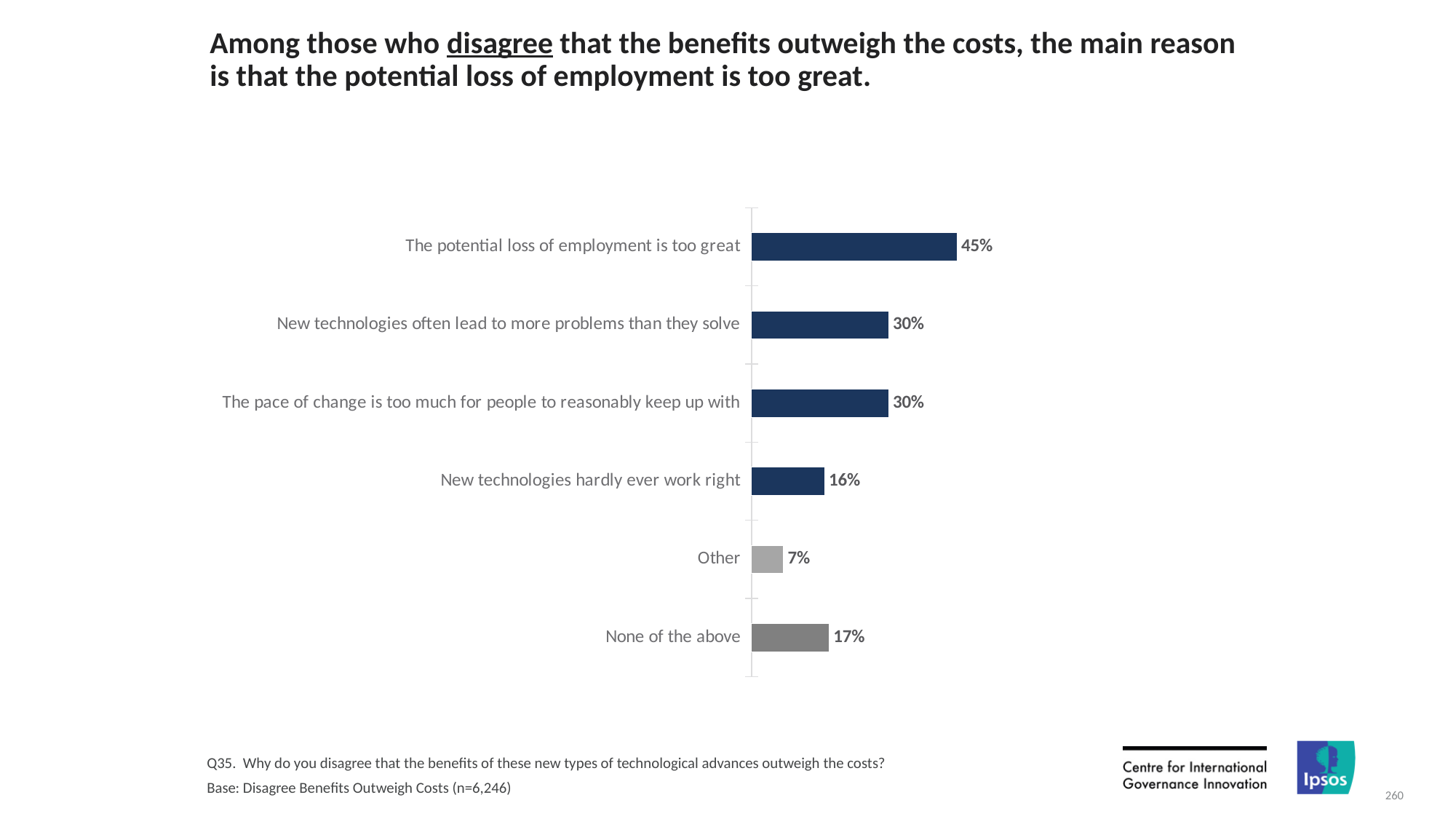
What is the difference between "The potential loss of employment is too great" and "New technologies often lead to more problems than they solve"? 15 percentage points What percentage chose "None of the above"? 17% What percentage of respondents said the potential loss of employment is too great? 45% How many categories are shown in the chart? 6 What kind of chart is shown on the slide? Bar chart Which category has the lowest percentage? Other Which reason has the highest percentage? The potential loss of employment is too great Which is larger: "None of the above" or "New technologies hardly ever work right"? None of the above What is the base size (n) stated at the bottom of the slide? n=6,246 What is the value for "New technologies hardly ever work right"? 16% What is the value for "Other"? 7% What is the value for "The pace of change is too much for people to reasonably keep up with"? 30%